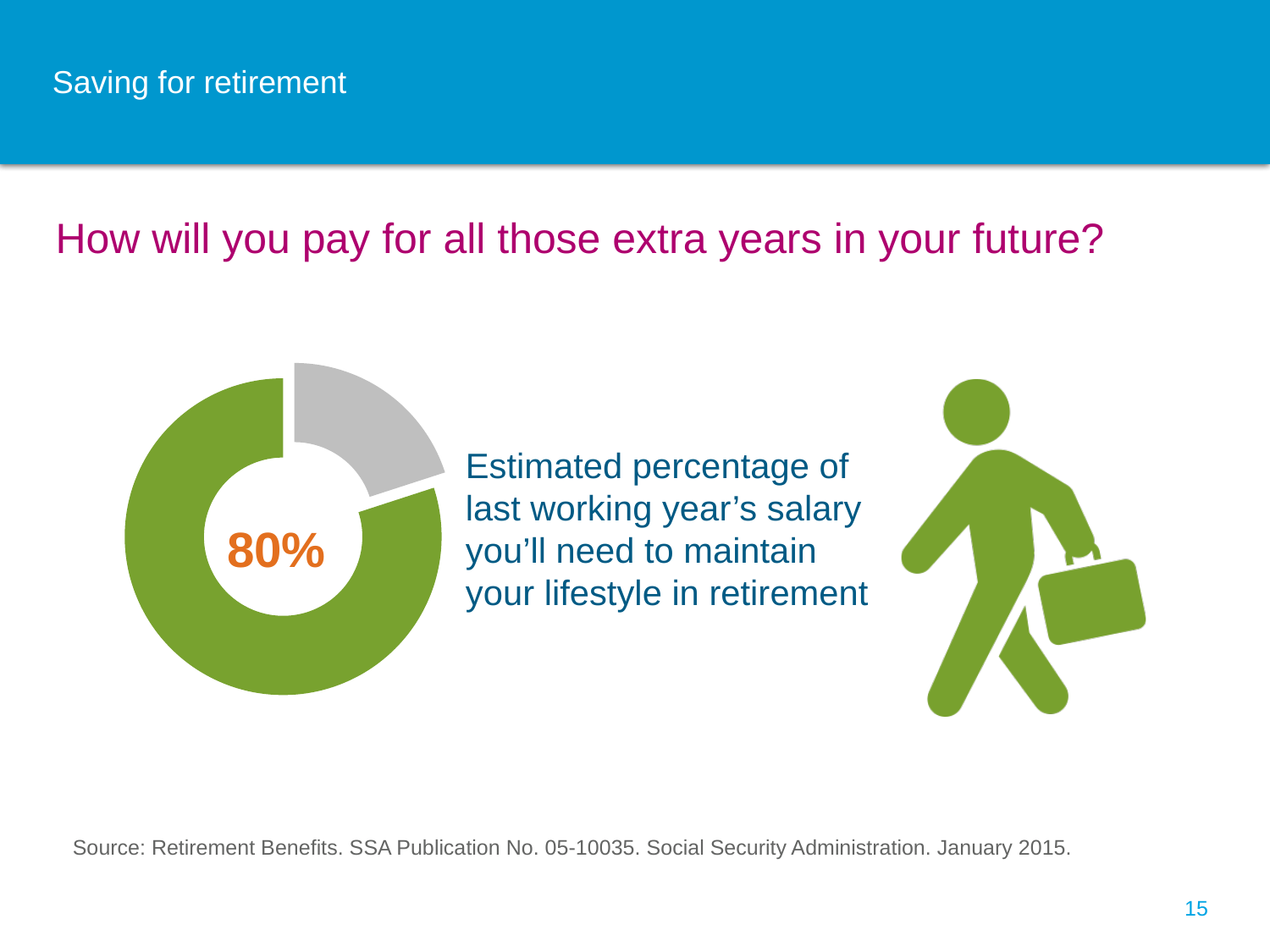
What colour is the larger segment of the donut chart? Green Which segment of the donut chart is larger, the green one or the gray one? Green Is the value shown in the donut chart greater or less than 50%? greater What does the 80% in the donut chart represent, according to the text beside it? Estimated percentage of last working year's salary you'll need to maintain your lifestyle in retirement What percentage is printed in the centre of the donut chart? 80% What kind of chart is shown on the slide? Donut chart What share of the donut chart does the green segment represent? 80% What share of the donut chart does the gray segment represent? 20% How many segments does the donut chart have? 2